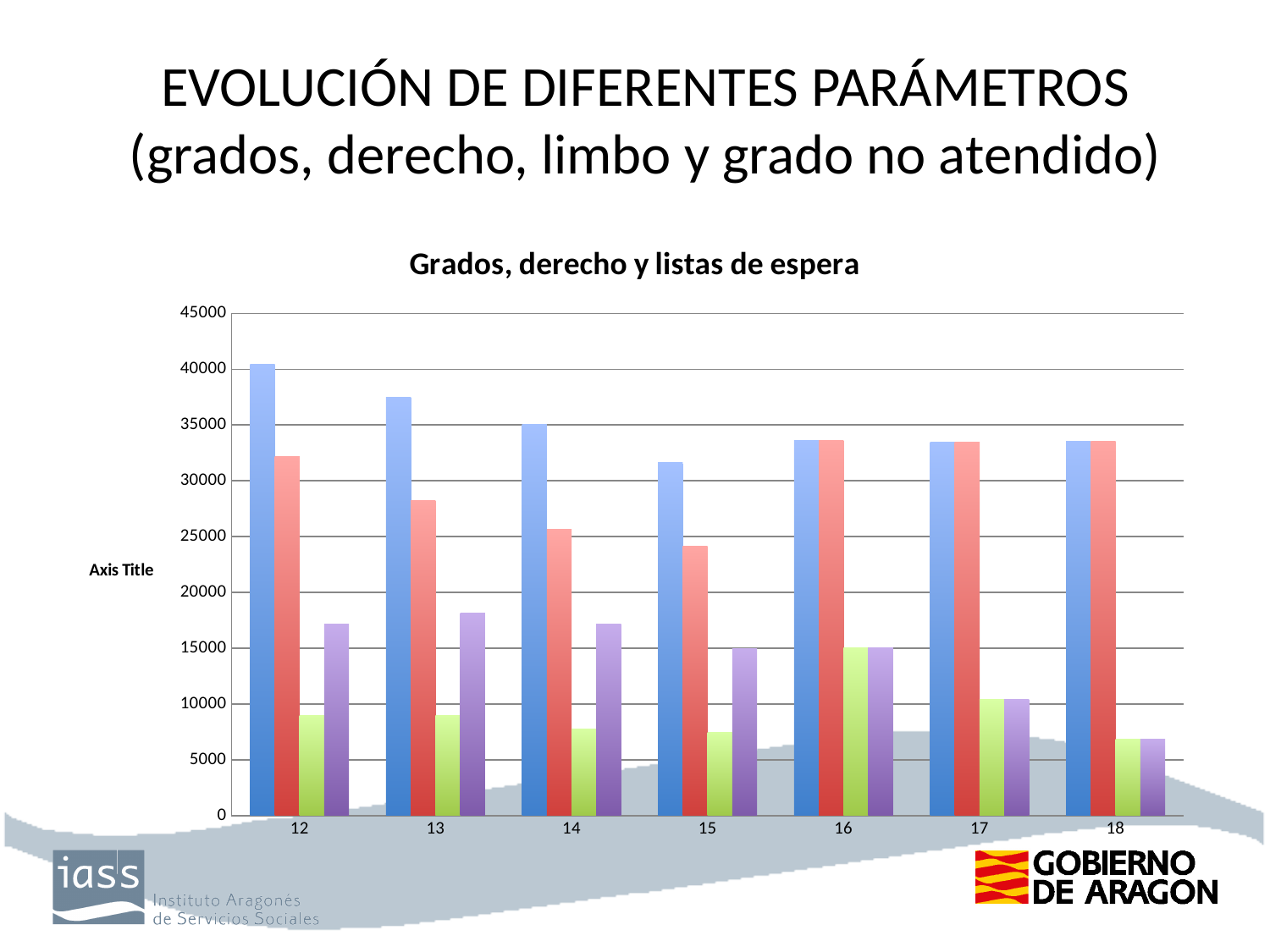
How many categories are shown on the x axis of the chart? 7 Is the value of the red bar for category 15 greater or less than 25000? less Is the value of the blue bar for category 12 greater or less than 35000? greater What kind of chart is shown on the slide? bar chart What is the title of the chart? Grados, derecho y listas de espera Is the value of the red bar for category 12 greater or less than 30000? greater For category 12, which is larger, the blue bar or the red bar? the blue bar For which category is the blue bar the highest? 12 How many bars are plotted for each category on the x axis? 4